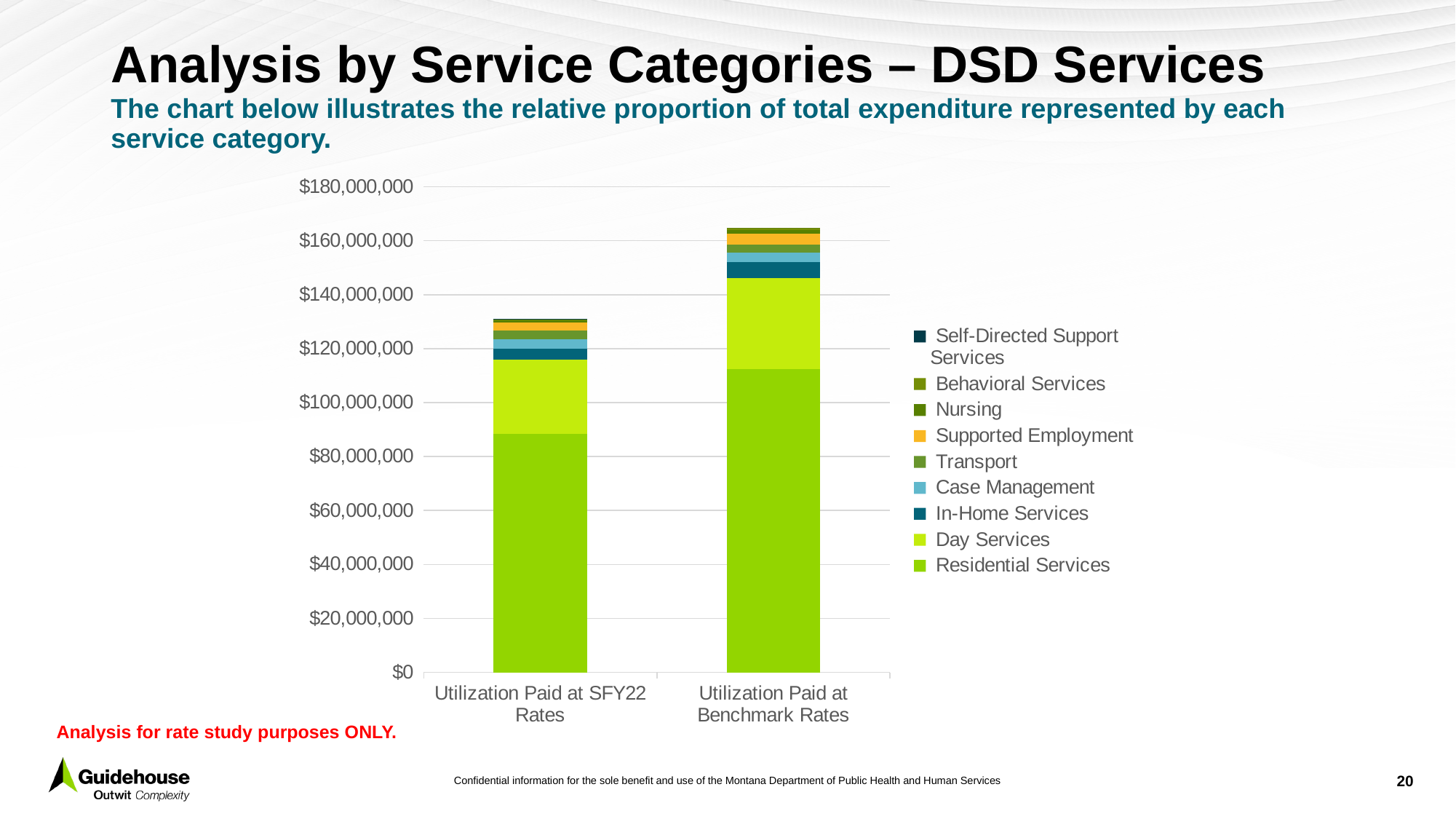
Which bar is taller overall, Utilization Paid at SFY22 Rates or Utilization Paid at Benchmark Rates? Utilization Paid at Benchmark Rates Is the total for Utilization Paid at SFY22 Rates greater or less than $120,000,000? greater Which service category makes up the largest segment of each bar? Residential Services Do the total values rise or fall from Utilization Paid at SFY22 Rates to Utilization Paid at Benchmark Rates? rise How many bars (categories) are plotted on the x axis? 2 Is the Residential Services segment for Utilization Paid at Benchmark Rates greater or less than $100,000,000? greater What kind of chart is shown on the slide? Stacked bar chart Which legend entry is listed first at the top of the legend? Self-Directed Support Services Is the total for Utilization Paid at SFY22 Rates greater or less than $140,000,000? less How many series does the legend list? 9